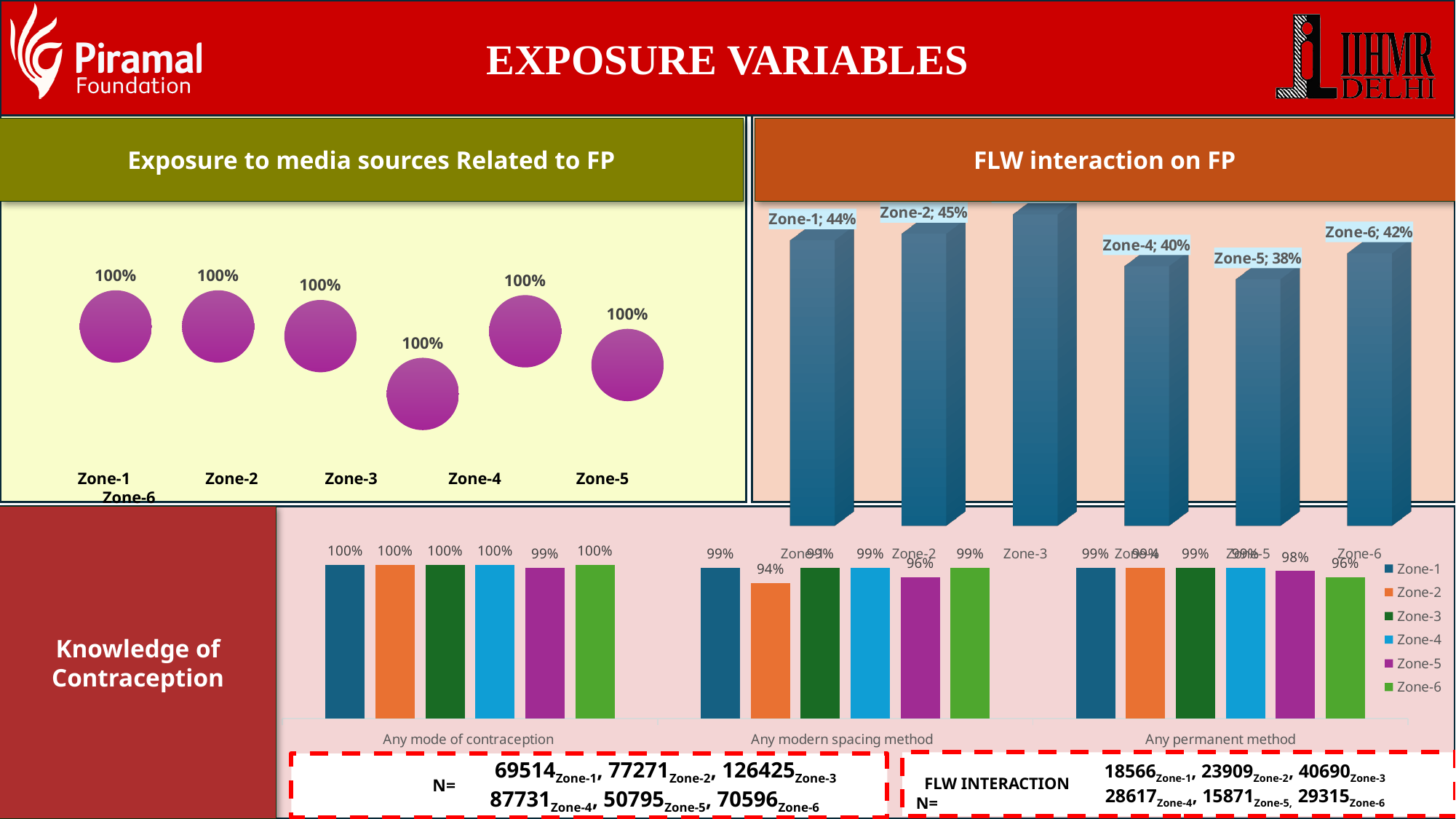
In the 'FLW interaction on FP' chart, which zone has the tallest bar? Zone-3 In the 'Knowledge of Contraception' chart, what is the value for Zone-6 under 'Any permanent method'? 96% In the 'FLW interaction on FP' chart, which zone has the lowest value? Zone-5 What kind of chart is the 'Knowledge of Contraception' chart? Bar chart In the 'FLW interaction on FP' chart, what is the value for Zone-2? 45% In the 'Exposure to media sources Related to FP' chart, what is the value for Zone-4? 100% How many series does the legend of the 'Knowledge of Contraception' chart list? 6 In the 'Knowledge of Contraception' chart, what is the value for Zone-2 under 'Any modern spacing method'? 94% In the 'FLW interaction on FP' chart, what is the difference between the values for Zone-1 and Zone-4? 4% How many zones are shown in the 'Exposure to media sources Related to FP' chart? 6 In the 'FLW interaction on FP' chart, what is the value for Zone-5? 38% In the 'FLW interaction on FP' chart, which is larger, the value for Zone-6 or the value for Zone-5? Zone-6